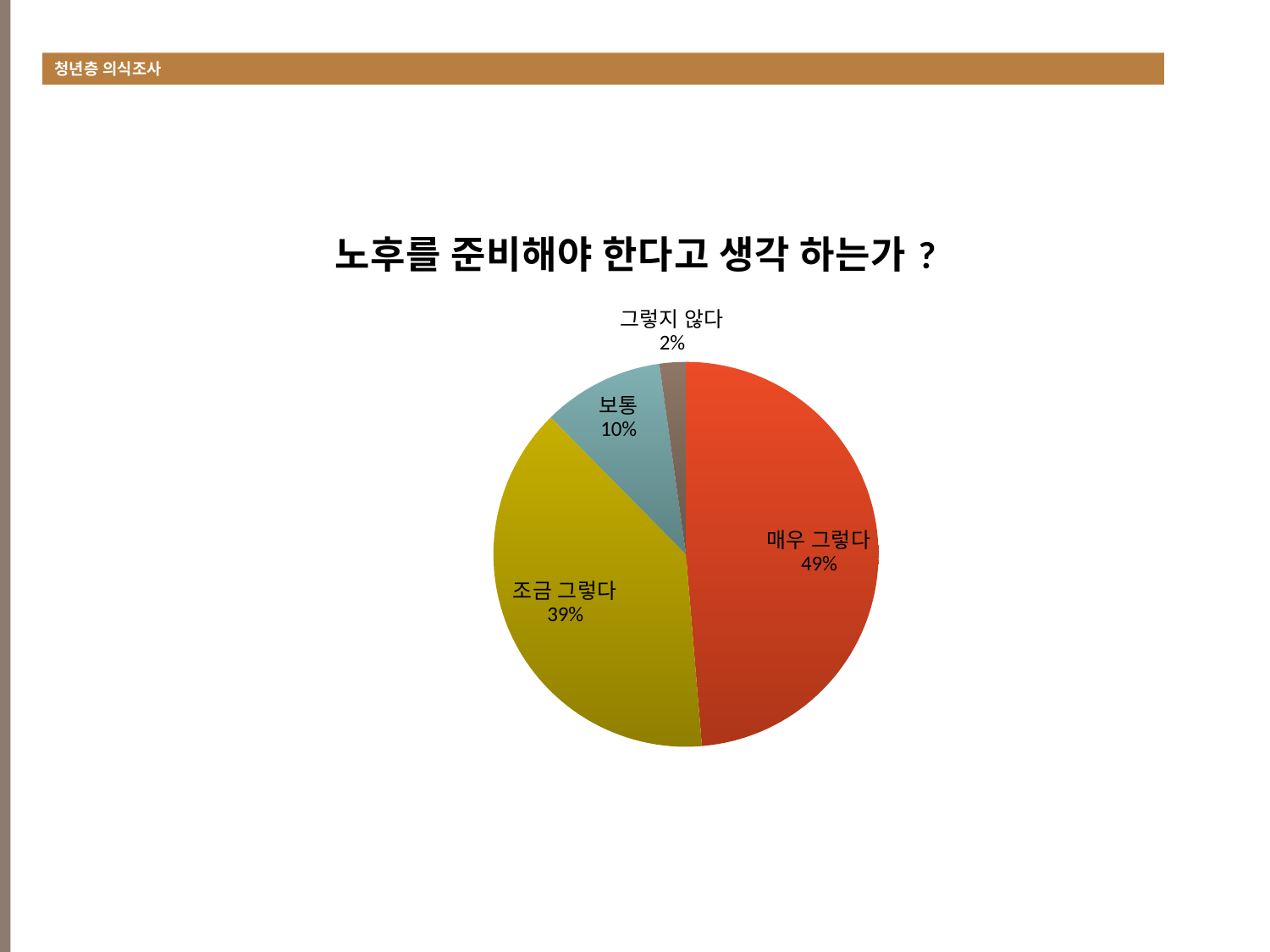
How many categories are shown in the pie chart? 4 Which response has the smallest share of the pie? 그렇지 않다 What is the difference in percentage points between 매우 그렇다 and 조금 그렇다? 10 What is the title of the chart? 노후를 준비해야 한다고 생각 하는가 ? Which response has the largest share of the pie? 매우 그렇다 What percentage of respondents answered 매우 그렇다? 49% Which is larger, the share for 보통 or the share for 그렇지 않다? 보통 What is the combined share of 매우 그렇다 and 조금 그렇다? 88% What kind of chart is shown on the slide? Pie chart What percentage of respondents answered 보통? 10% What percentage of respondents answered 그렇지 않다? 2% What percentage of respondents answered 조금 그렇다? 39%